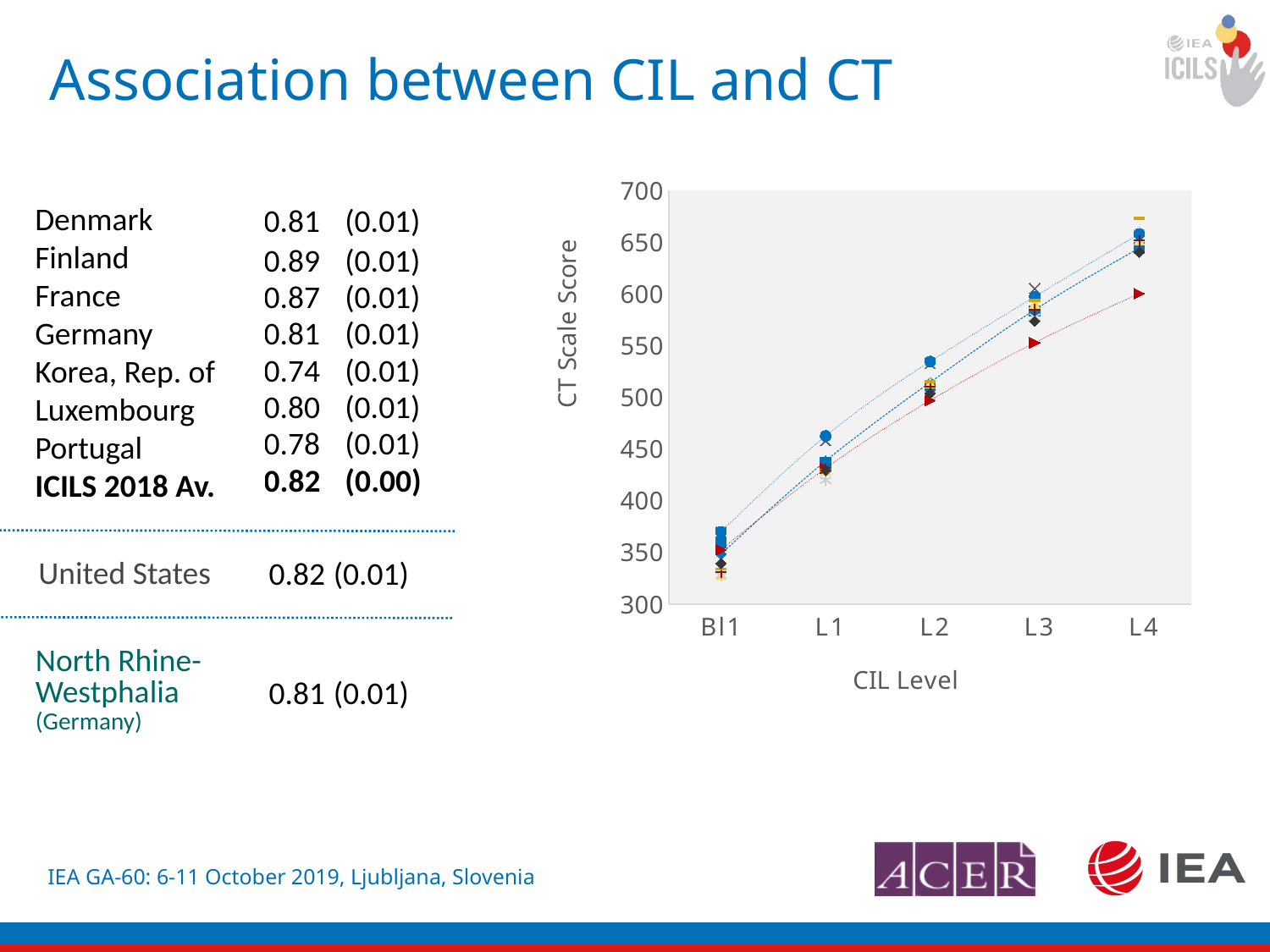
What is the title of the y axis of the chart? CT Scale Score What is the title of the x axis of the chart? CIL Level Are the CT scale scores plotted at L2 greater or less than 550? less Are the CT scale scores plotted at L2 greater or less than 450? greater Are the CT scale scores plotted at L1 greater or less than 400? greater Which CIL level has the highest CT scale scores in the chart? L4 Which CIL level has the lowest CT scale scores in the chart? Bl1 Do the CT scale scores rise or fall as the CIL level increases from Bl1 to L4? rise What kind of chart is shown on the slide? line chart How many CIL levels are shown on the x axis of the chart? 5